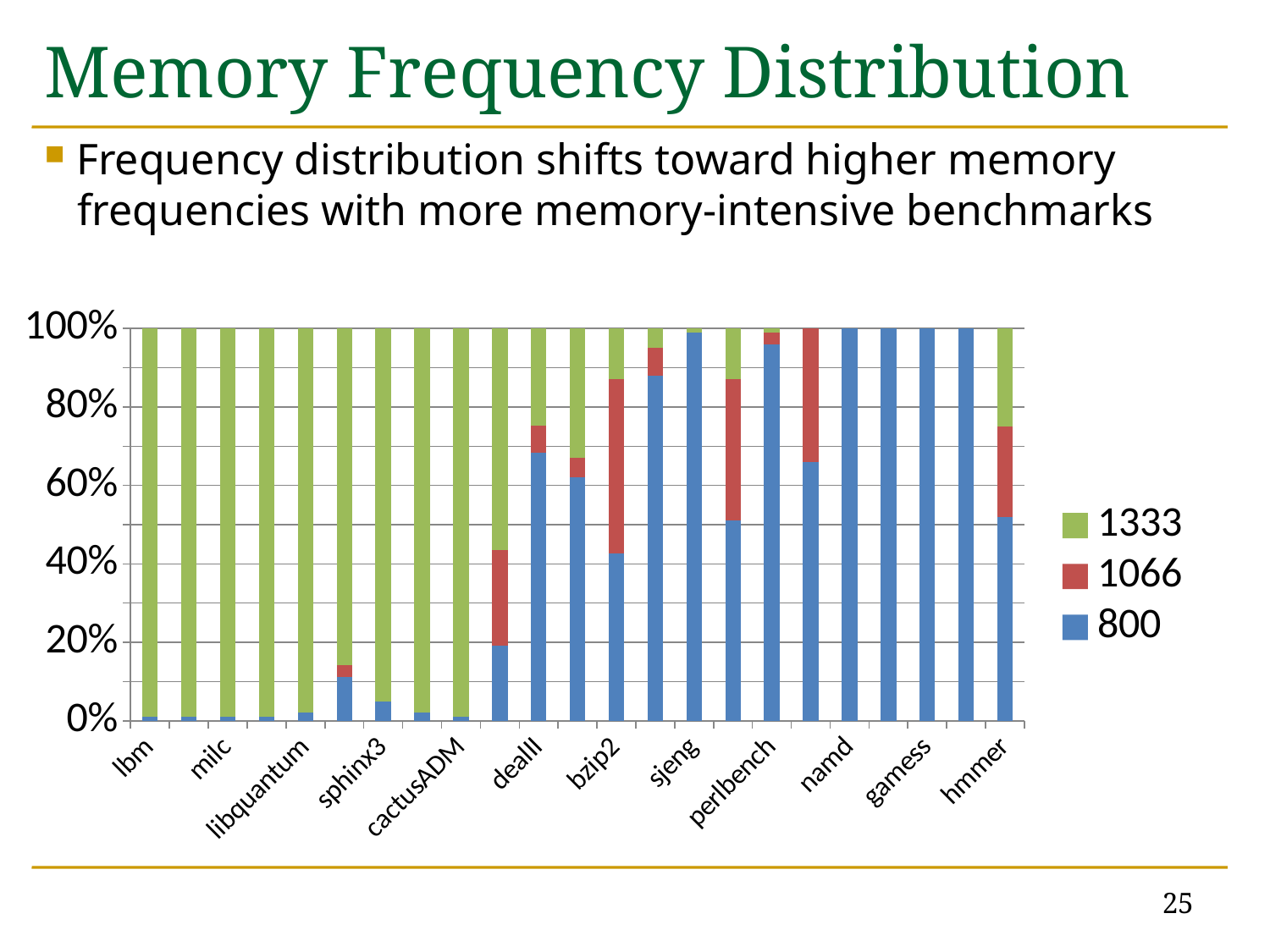
What kind of chart is shown on the slide? stacked bar chart What are the three series named in the legend? 1333, 1066, 800 Is the 800 share for sjeng greater or less than 80%? greater Is the 1333 share for lbm greater or less than 80%? greater How many series does the legend list? 3 Which has a larger 1333 share, milc or perlbench? milc Which series is shown in blue? 800 Is the 800 share for dealII greater or less than 60%? greater Which has a larger 800 share, namd or hmmer? namd